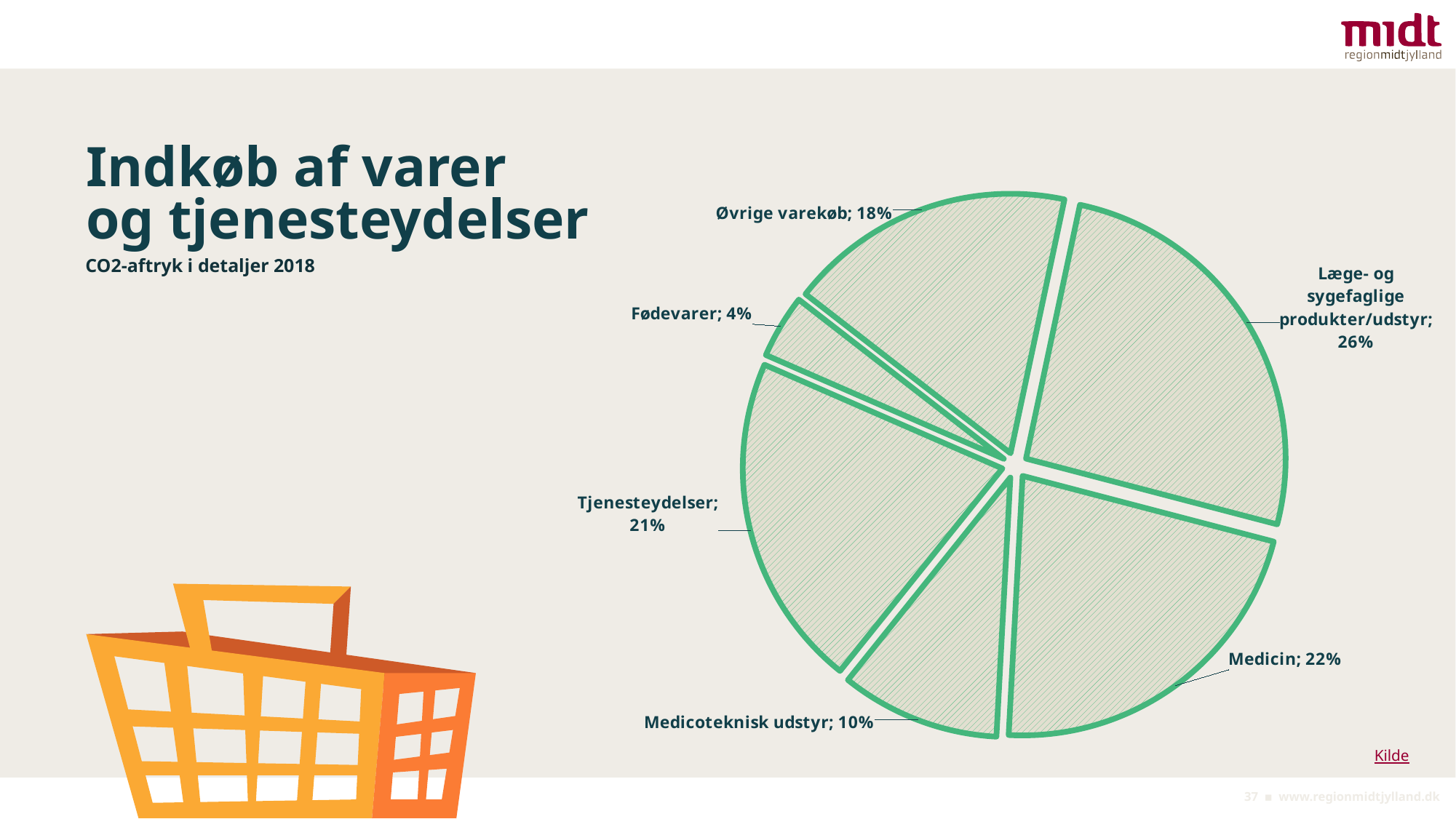
What is the value shown for Fødevarer? 4% Which category has the smallest slice of the pie? Fødevarer What is the subtitle printed under the slide title? CO2-aftryk i detaljer 2018 What is the value shown for Medicoteknisk udstyr? 10% Which is larger, Medicin or Tjenesteydelser? Medicin What kind of chart is shown on the slide? pie chart What is the difference in percentage points between Læge- og sygefaglige produkter/udstyr and Øvrige varekøb? 8 What is the difference in percentage points between Medicoteknisk udstyr and Fødevarer? 6 What is the value shown for Tjenesteydelser? 21% How many categories are shown in the pie chart? 6 Which category has the largest slice of the pie? Læge- og sygefaglige produkter/udstyr What share of the pie does Medicin account for? 22%